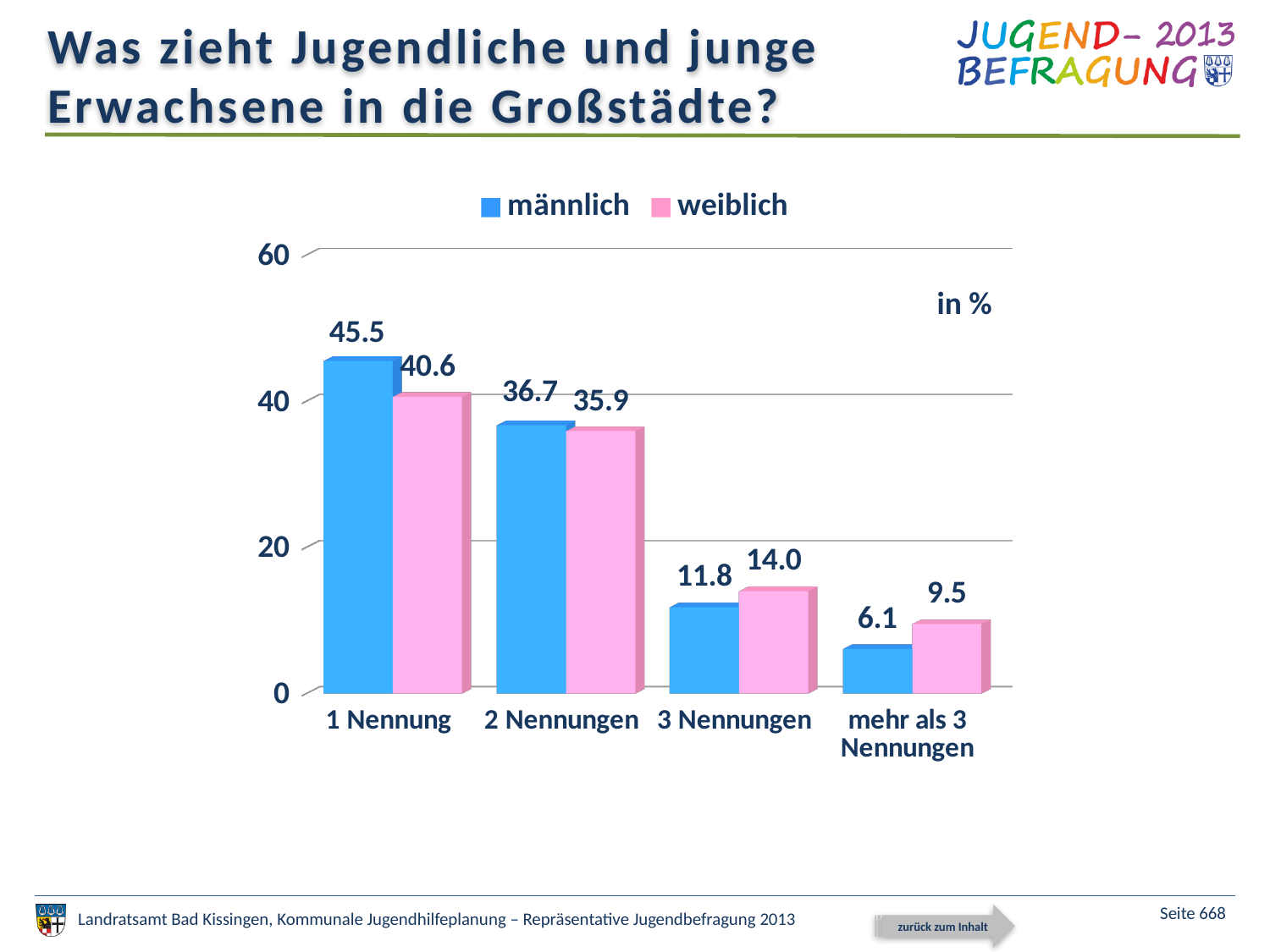
What is the value for männlich in the '1 Nennung' category? 45.5 What is the difference between the männlich and weiblich values in the '1 Nennung' category? 4.9 How many categories are shown on the x axis? 4 Is the männlich value for '2 Nennungen' greater or less than 40? less Which category has the highest value for männlich? 1 Nennung What is the value for weiblich in the 'mehr als 3 Nennungen' category? 9.5 What is the value for weiblich in the '3 Nennungen' category? 14.0 What is the difference between the weiblich and männlich values in the 'mehr als 3 Nennungen' category? 3.4 How many series does the legend list? 2 What kind of chart is shown on the slide? bar chart Which category has the lowest value for weiblich? mehr als 3 Nennungen In the '3 Nennungen' category, which is larger: männlich or weiblich? weiblich